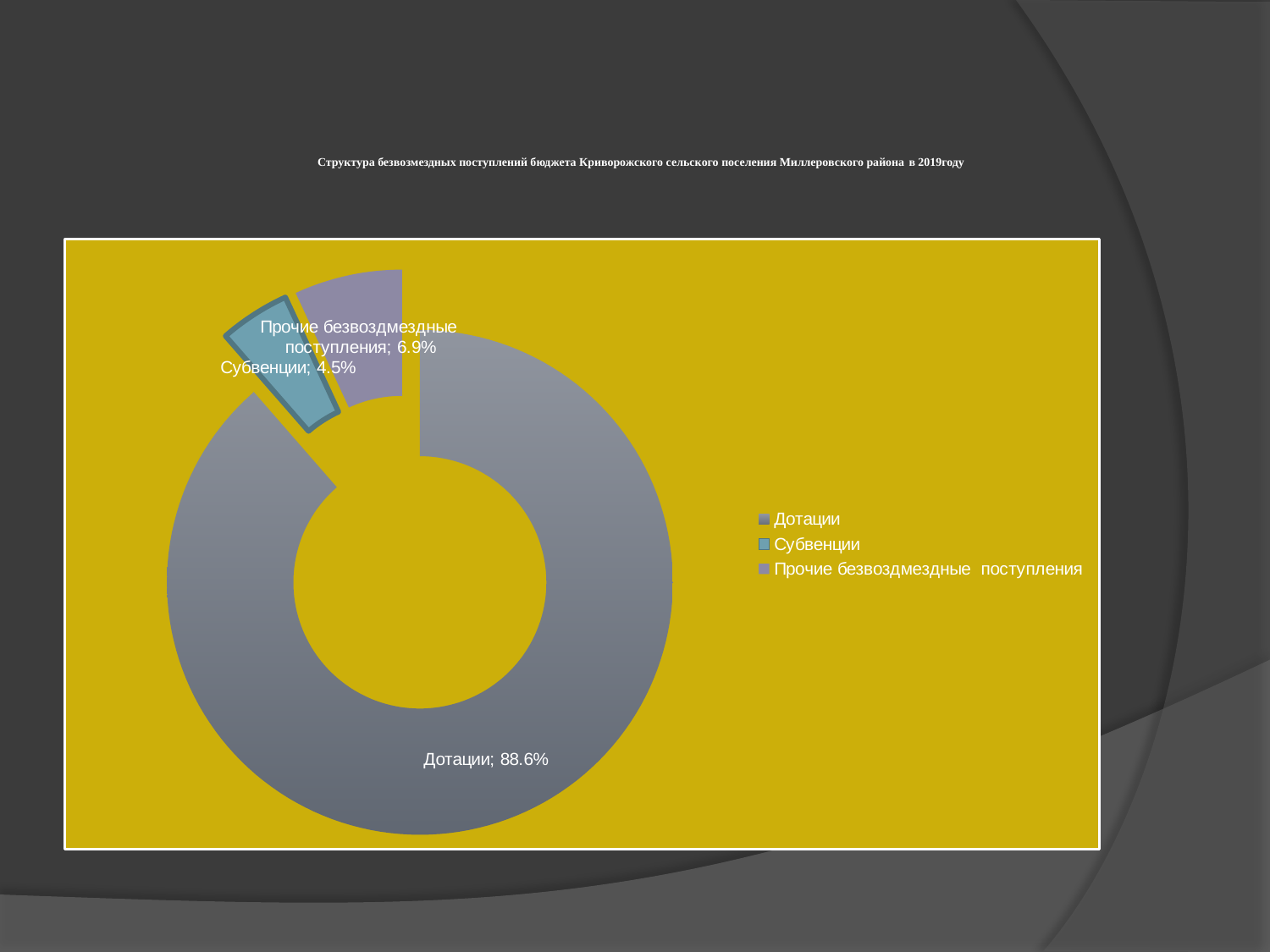
Which category has the smallest share of the chart? Субвенции What is the difference in percentage points between Дотации and Прочие безвозмездные поступления? 81.7 What is the value shown for Прочие безвозмездные поступления? 6.9% What is the difference in percentage points between Прочие безвозмездные поступления and Субвенции? 2.4 How many categories are shown in the chart? 3 How many entries does the legend list? 3 What share of the chart does Дотации account for? 88.6% Which is larger, Субвенции or Прочие безвозмездные поступления? Прочие безвозмездные поступления Which category has the largest share of the chart? Дотации What kind of chart is shown on the slide? Doughnut (pie) chart For which year does the chart title say the data is shown? 2019 What is the value shown for Субвенции? 4.5%